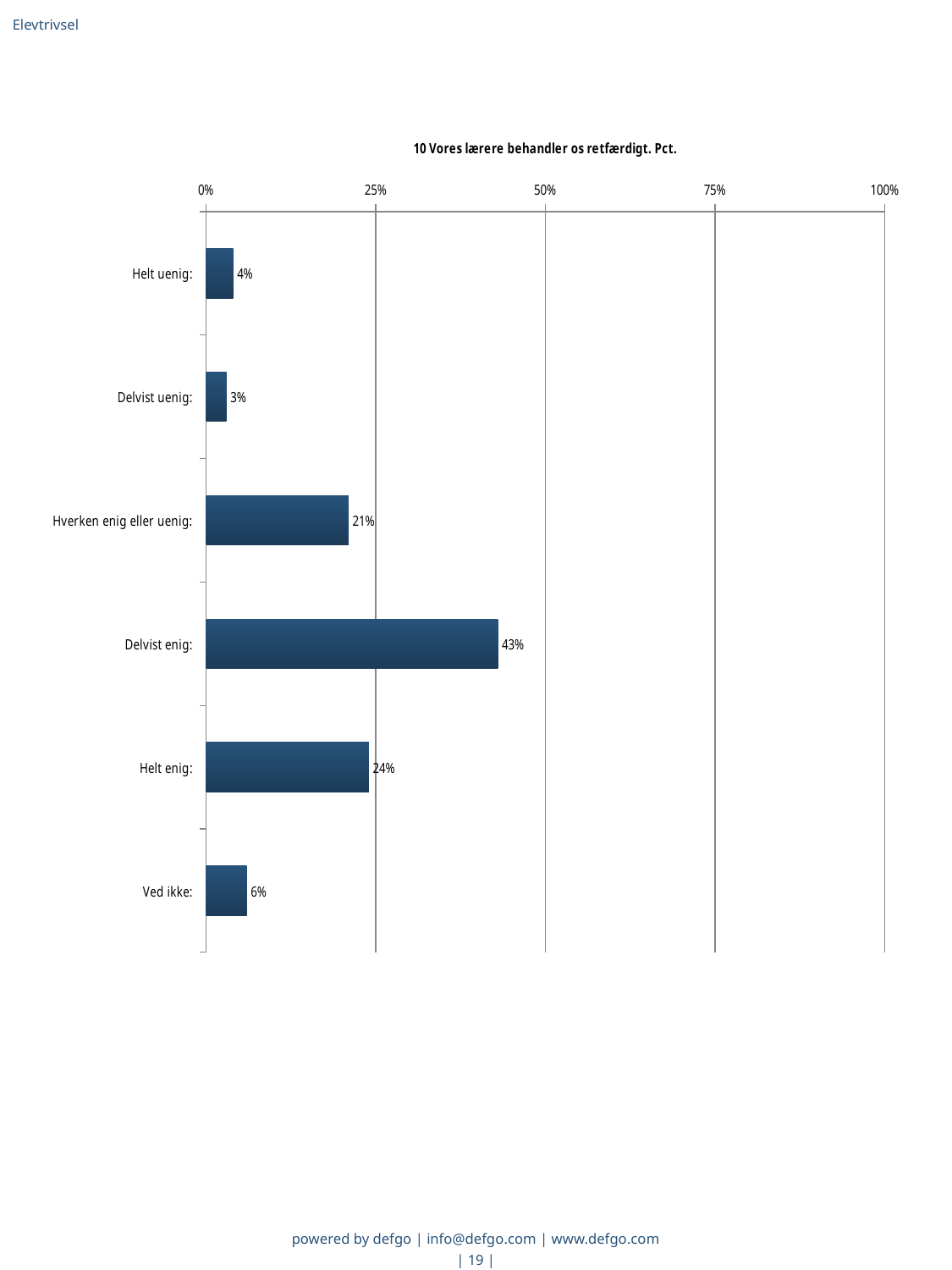
What is the value for "Delvist enig"? 43% What is the value for "Ved ikke"? 6% What is the difference between the values for "Helt uenig" and "Delvist uenig"? 1% Which category has the lowest value? Delvist uenig Which category has the highest value? Delvist enig Is the value for "Delvist enig" greater or less than 50%? less What is the difference between the values for "Delvist enig" and "Helt enig"? 19% What kind of chart is shown on the slide? bar chart How many categories are shown in the chart? 6 Which is larger, the value for "Helt enig" or the value for "Hverken enig eller uenig"? Helt enig What is the title of the chart? 10 Vores lærere behandler os retfærdigt. Pct. What is the value for "Hverken enig eller uenig"? 21%